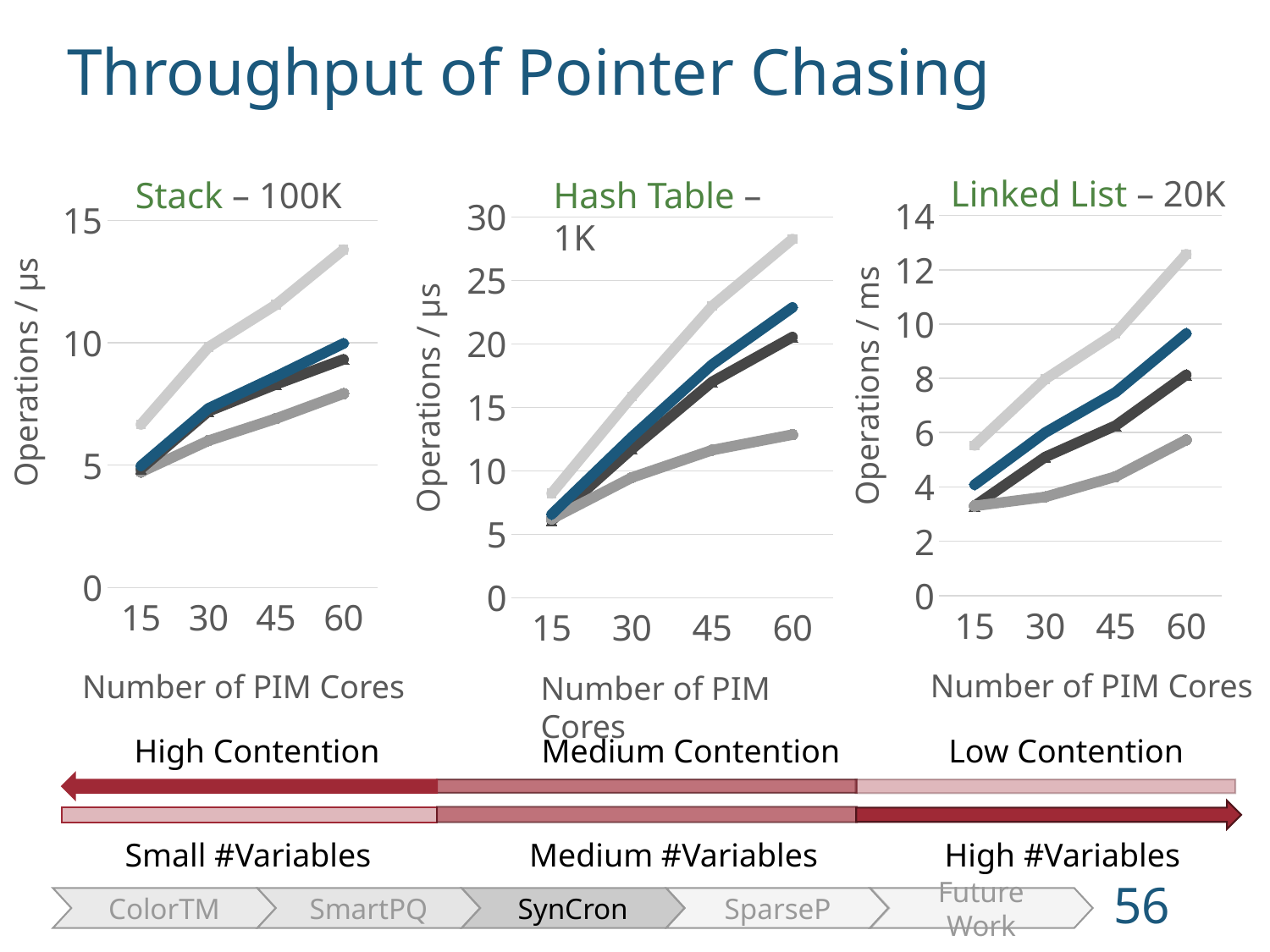
How many x-axis points (numbers of PIM cores) are plotted in the Hash Table – 1K chart? 4 In the Stack – 100K chart, is the value of the topmost line at 60 PIM cores greater or less than 10? greater In the Hash Table – 1K chart, is the value of the topmost line at 60 PIM cores greater or less than 25? greater In the Hash Table – 1K chart, which number of PIM cores gives the highest throughput for the topmost line? 60 What is the x-axis label of the Stack – 100K chart? Number of PIM Cores In the Hash Table – 1K chart, is the value of the lowest line at 60 PIM cores greater or less than 15? less What kind of chart is the Stack – 100K chart? line chart In the Linked List – 20K chart, do the lines rise or fall as the number of PIM cores increases? rise What is the y-axis label of the Linked List – 20K chart? Operations / ms